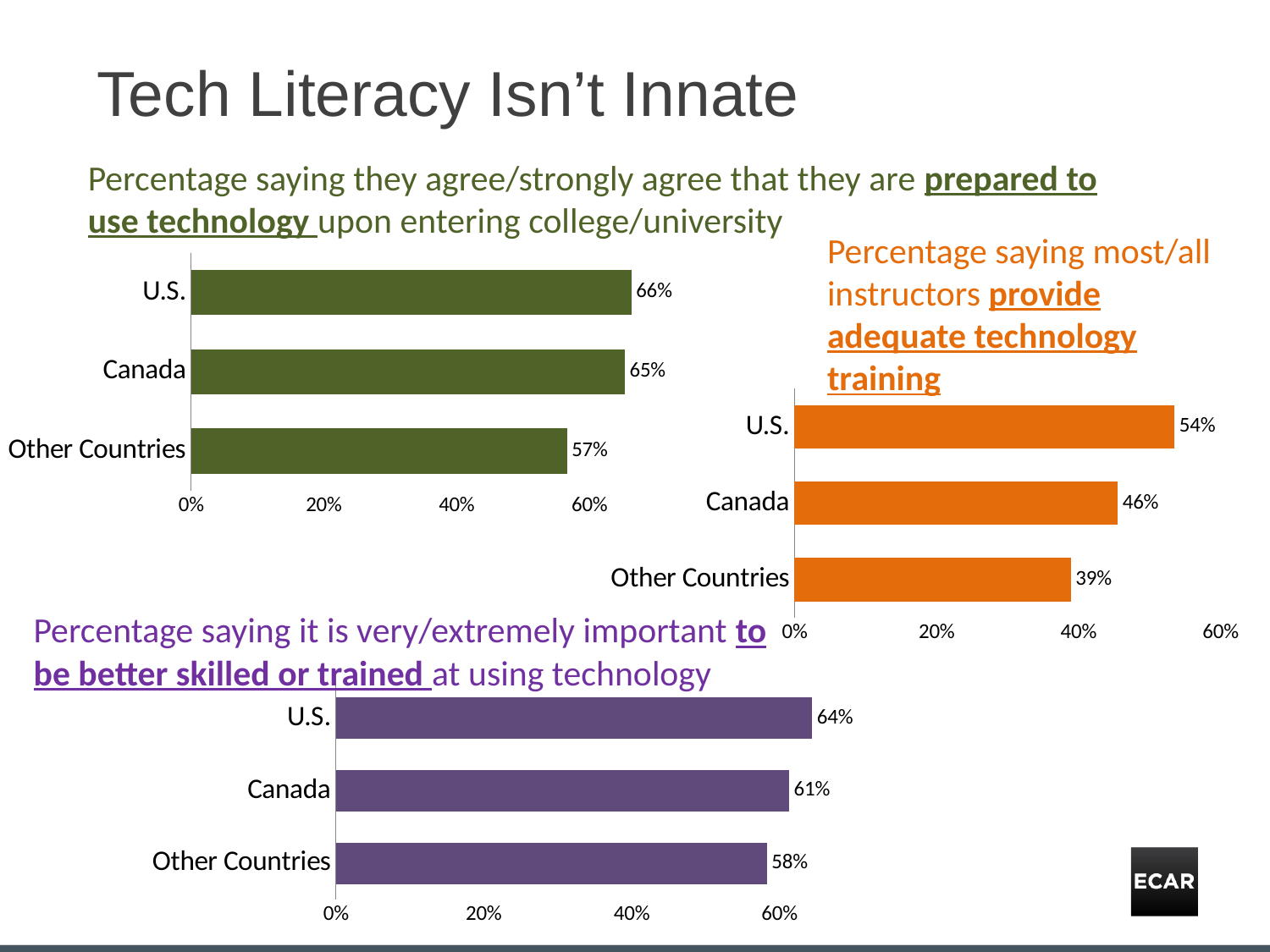
In the 'provide adequate technology training' chart (right), what is the value for Other Countries? 39% What kind of chart is the 'provide adequate technology training' chart (right)? Bar chart In the 'provide adequate technology training' chart (right), which category has the highest value? U.S. In the 'prepared to use technology' chart (top left), what is the value for Canada? 65% What colour are the bars in the 'better skilled or trained' chart (bottom)? Purple How many categories are shown in the 'prepared to use technology' chart (top left)? 3 In the 'better skilled or trained' chart (bottom), what is the value for U.S.? 64% In the 'better skilled or trained' chart (bottom), what is the difference between the Canada and Other Countries values? 3% In the 'better skilled or trained' chart (bottom), which is larger, the value for U.S. or the value for Other Countries? U.S. In the 'provide adequate technology training' chart (right), is the value for Canada greater or less than 40%? greater In the 'provide adequate technology training' chart (right), what is the difference between the U.S. and Canada values? 8% In the 'prepared to use technology' chart (top left), which category has the lowest value? Other Countries